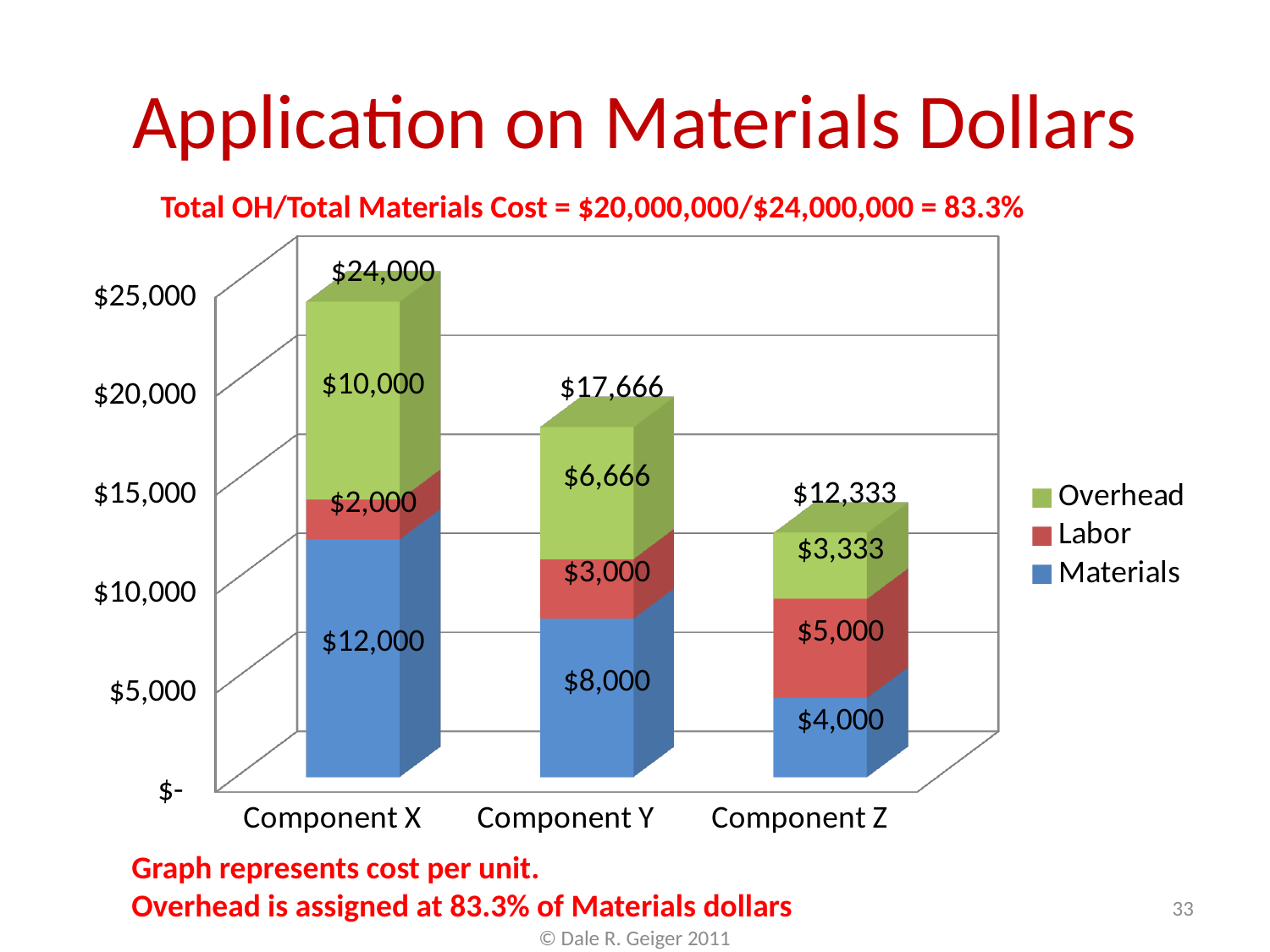
Which component has the lowest Materials cost? Component Z Which is larger, the Labor cost for Component Y or the Labor cost for Component Z? Component Z What is the Labor cost for Component Z? $5,000 How many components are shown on the x axis? 3 What is the Materials cost for Component X? $12,000 What is the difference between the Materials cost of Component X and Component Y? $4,000 Which component has the highest total cost per unit? Component X What kind of chart is shown on the slide? Stacked bar chart How many series does the legend list? 3 What is the total cost per unit for Component Z? $12,333 What is the Overhead cost for Component Y? $6,666 Which colour represents Overhead in the chart? Green